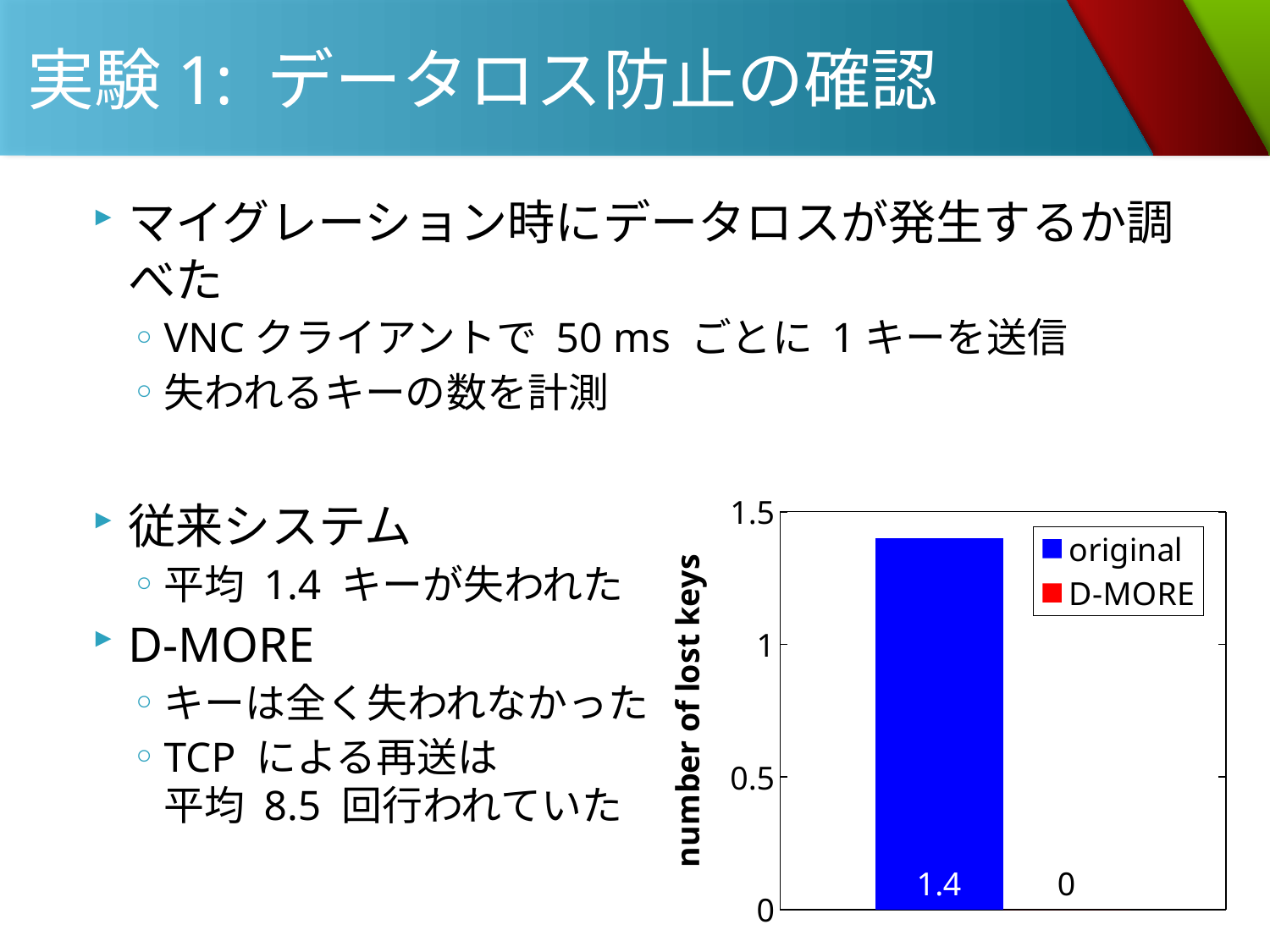
What is the number of lost keys for original? 1.4 Is the number of lost keys for original greater or less than 1? greater Which series has the lowest number of lost keys? D-MORE What colour is the bar for original? blue Which series has the higher number of lost keys, original or D-MORE? original What is the maximum value shown on the y axis? 1.5 What is the difference in number of lost keys between original and D-MORE? 1.4 What kind of chart is shown on the slide? bar chart What is the label of the y axis of the chart? number of lost keys What is the number of lost keys for D-MORE? 0 How many series does the legend list? 2